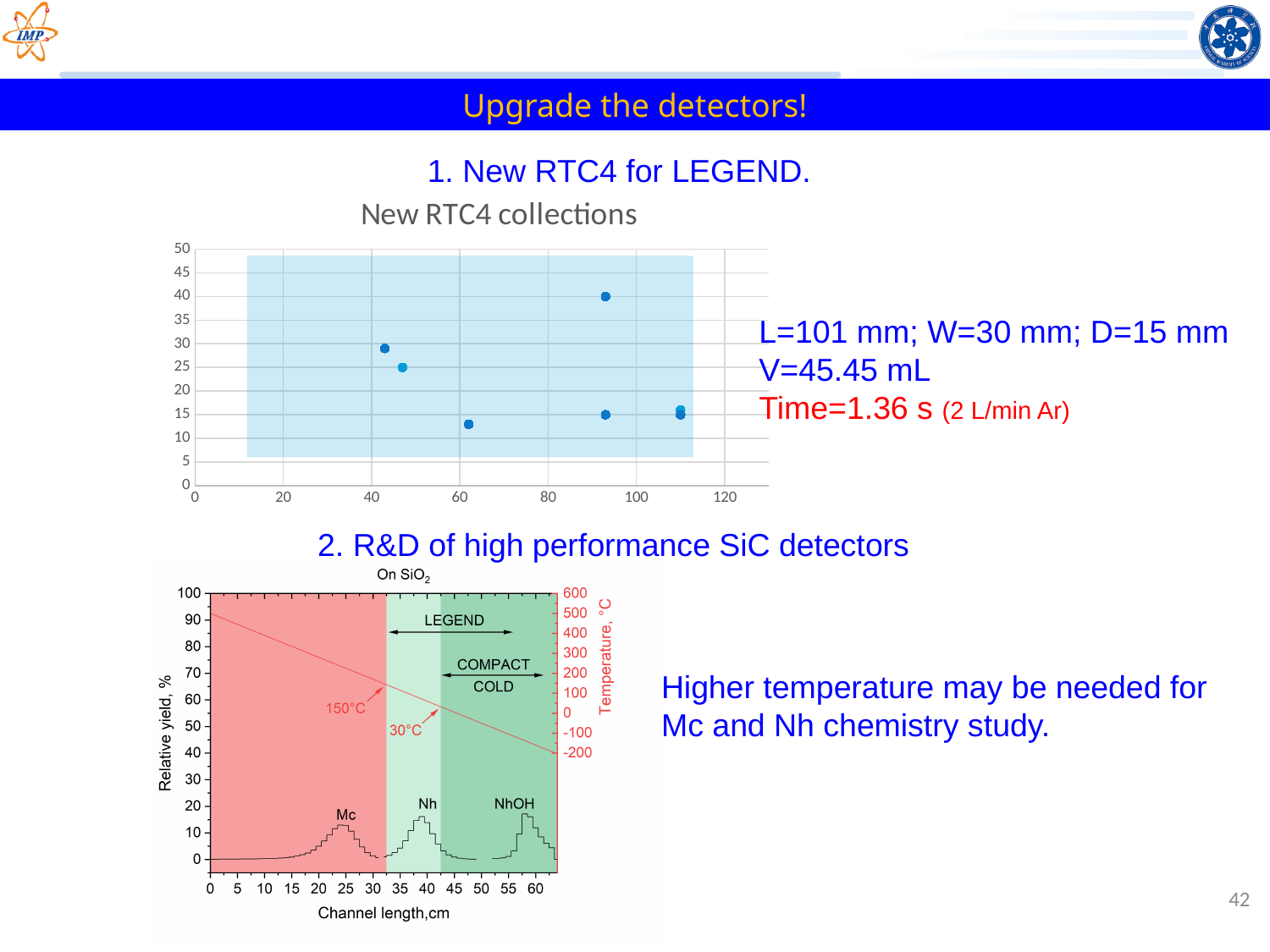
In the bottom chart "On SiO2", what is the label of the left vertical axis? Relative yield, % In the top chart "New RTC4 collections", is the highest plotted point greater or less than 35 on the vertical axis? greater In the top chart "New RTC4 collections", is the point plotted near x = 47 greater or less than 20 on the vertical axis? greater In the bottom chart "On SiO2", how many labelled peaks are shown in the relative yield curve? 3 In the bottom chart "On SiO2", does the red temperature line rise or fall as channel length increases? fall In the bottom chart "On SiO2", which labelled peak appears at the largest channel length? NhOH In the bottom chart "On SiO2", is the peak relative yield of Mc greater or less than 20%? less What is the title of the top chart on the slide? New RTC4 collections What kind of chart is the top chart titled "New RTC4 collections"? scatter chart